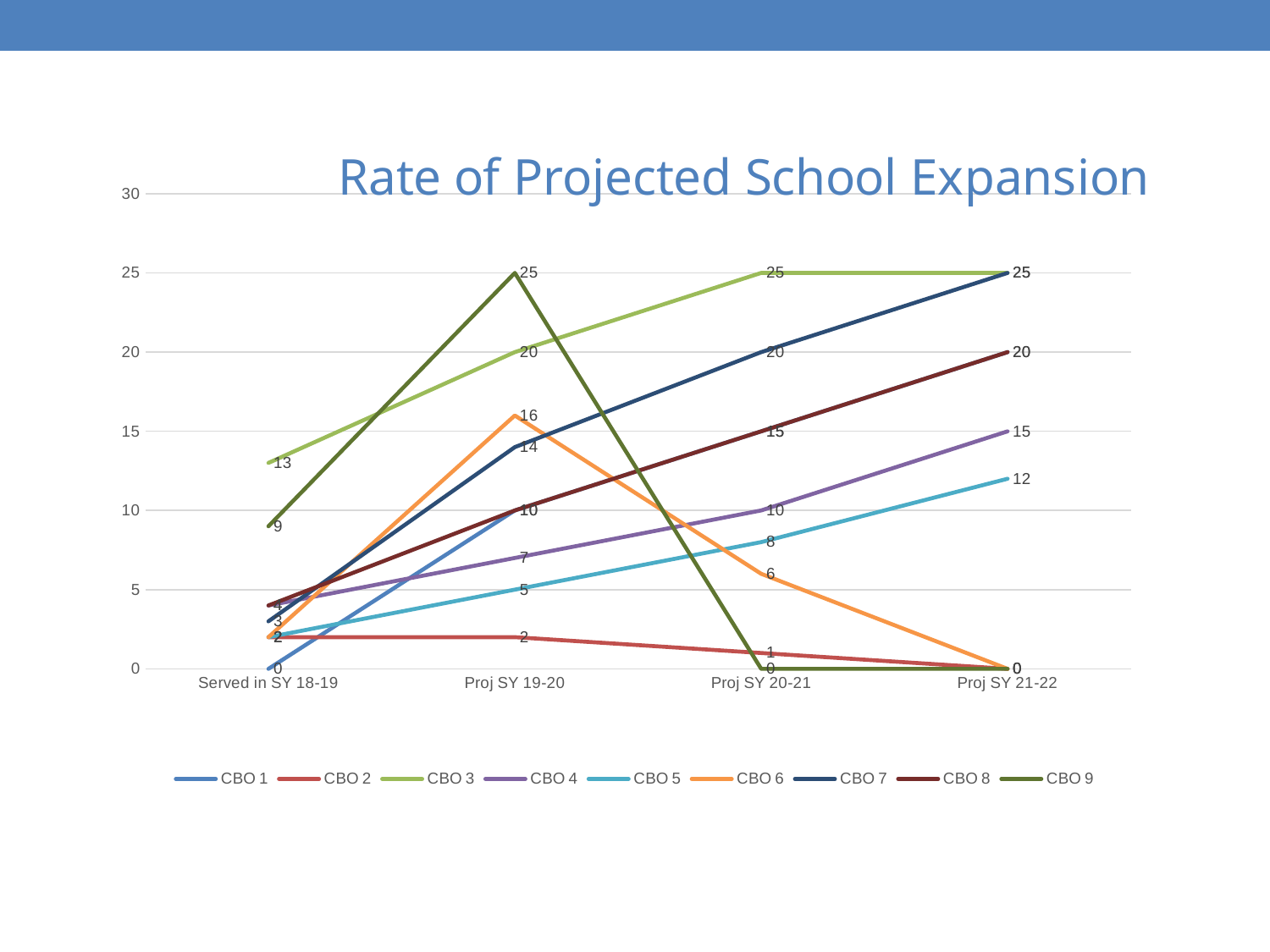
What is the value for CBO 6 at Proj SY 19-20? 16 What is the value for CBO 3 at Served in SY 18-19? 13 What kind of chart is shown on the slide? line chart Which is larger at Proj SY 19-20, CBO 6 or CBO 7? CBO 6 What is the difference between CBO 7 and CBO 8 at Proj SY 21-22? 5 What is the value for CBO 2 at Proj SY 20-21? 1 Do the values for CBO 5 rise or fall from Served in SY 18-19 to Proj SY 21-22? rise Which series has the lowest value at Proj SY 19-20? CBO 2 What is the value for CBO 5 at Proj SY 21-22? 12 How many series does the legend list? 9 How many categories are on the x axis? 4 Which series has the highest value at Proj SY 19-20? CBO 9